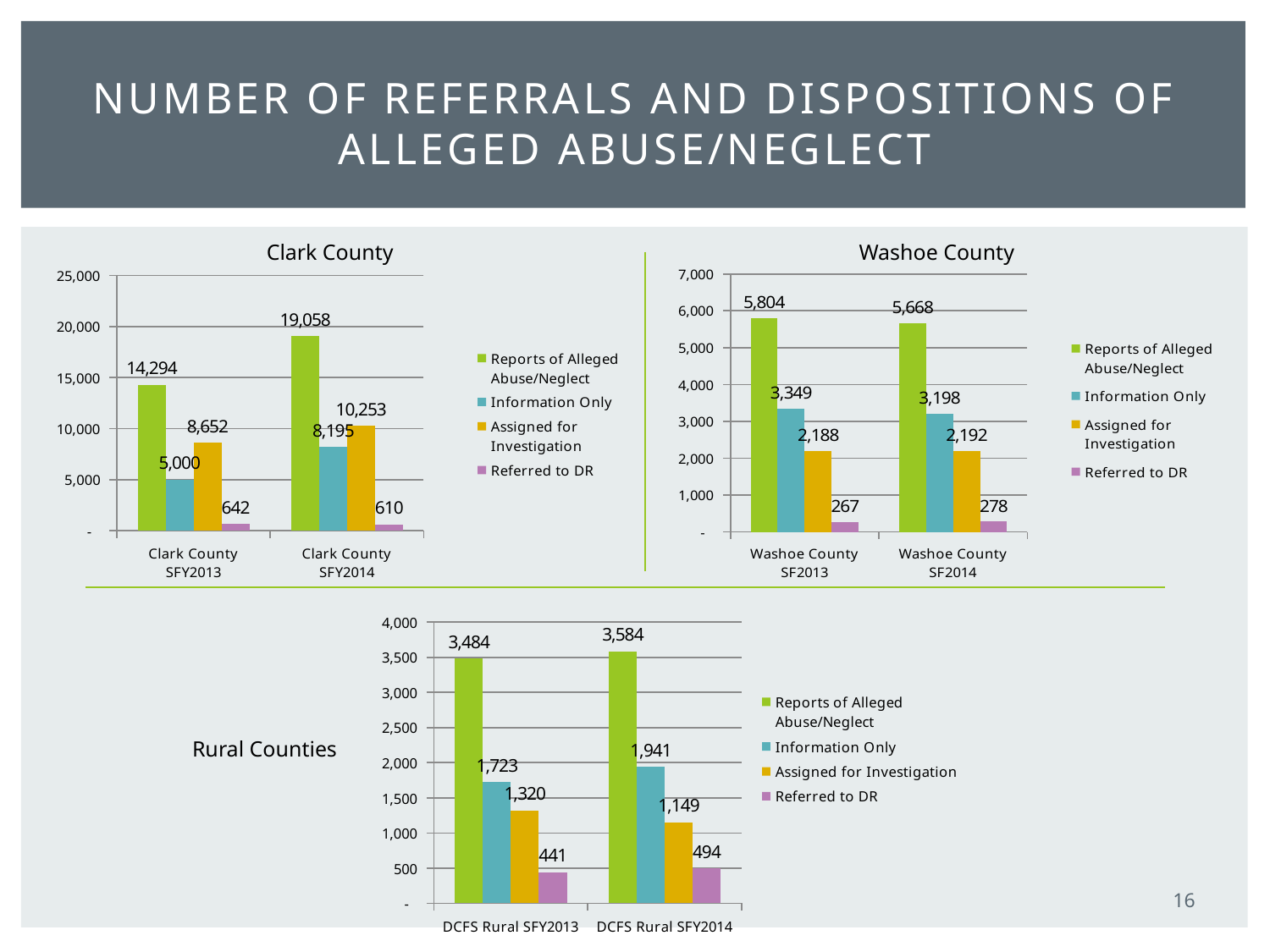
In the Rural Counties chart, which series has the lowest value in DCFS Rural SFY2013? Referred to DR In the Washoe County chart, what is the value for Assigned for Investigation in Washoe County SF2014? 2,192 In the Clark County chart, what is the value for Reports of Alleged Abuse/Neglect in Clark County SFY2014? 19,058 In the Clark County chart, what is the difference between Reports of Alleged Abuse/Neglect in SFY2014 and SFY2013? 4,764 How many series does the legend of the Clark County chart list? 4 In the Rural Counties chart, what is the difference between Assigned for Investigation in DCFS Rural SFY2013 and DCFS Rural SFY2014? 171 In the Clark County chart, what is the value for Information Only in Clark County SFY2013? 5,000 In the Rural Counties chart, what is the value for Information Only in DCFS Rural SFY2014? 1,941 In the Washoe County chart, what is the value for Referred to DR in Washoe County SF2013? 267 What kind of chart is the Washoe County chart? Bar chart In the Washoe County chart, which is larger: Reports of Alleged Abuse/Neglect in SF2013 or in SF2014? SF2013 In the Clark County chart, does the value for Referred to DR in SFY2013 rise or fall in SFY2014? Fall